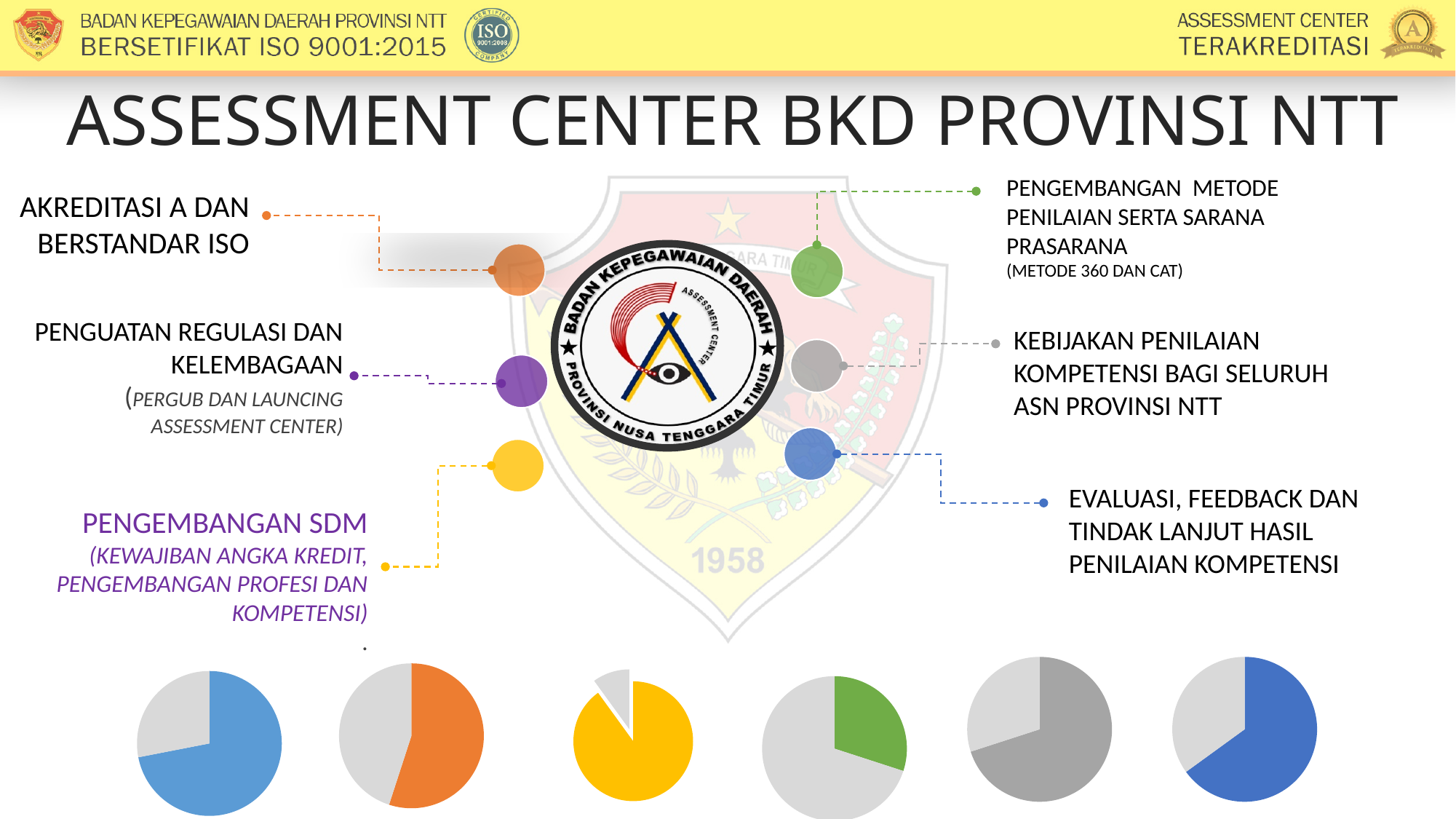
How many pie charts are shown along the bottom of the slide? 6 How many slices does the leftmost pie chart at the bottom of the slide have? 2 In the rightmost pie chart (blue), which slice is larger, the blue slice or the grey slice? Blue What kind of charts are shown along the bottom of the slide? Pie charts What colour is the larger slice in the fifth pie chart from the left? Dark grey In the third pie chart from the left (yellow), which slice is larger, the yellow slice or the grey slice? Yellow What colour is the larger slice in the second pie chart from the left? Orange In the leftmost pie chart (blue), which slice is larger, the blue slice or the grey slice? Blue